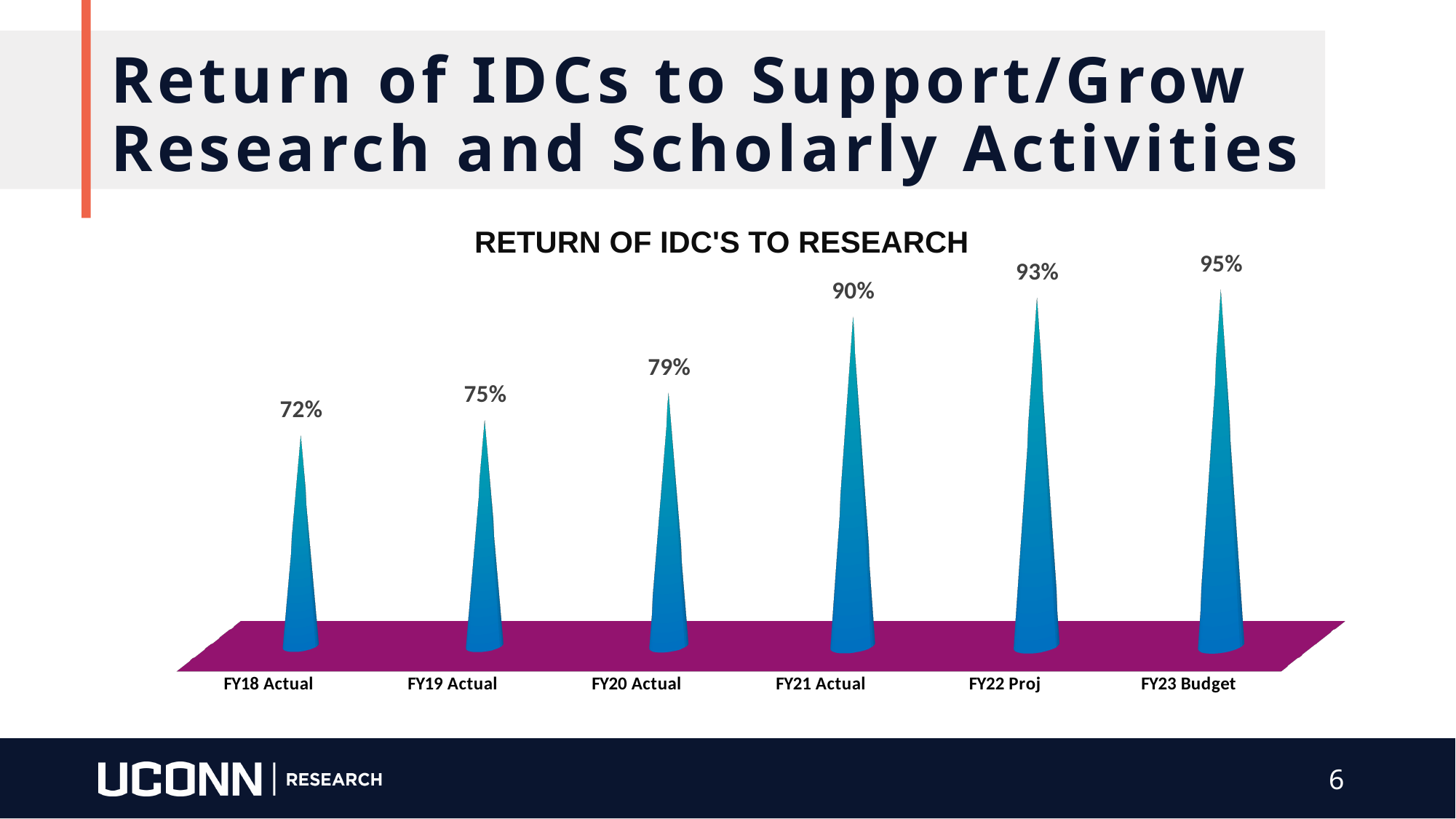
Which category has the highest value? FY23 Budget What is the value for FY18 Actual? 72% What is the title of the chart? RETURN OF IDC'S TO RESEARCH Do the values rise or fall from FY18 Actual to FY23 Budget? Rise What is the value for FY21 Actual? 90% What kind of chart is this? Bar chart What is the value for FY22 Proj? 93% Which is larger, the value for FY19 Actual or the value for FY20 Actual? FY20 Actual What is the difference between the values for FY23 Budget and FY18 Actual? 23% What is the difference between the values for FY21 Actual and FY20 Actual? 11% Which category has the lowest value? FY18 Actual How many categories are shown on the x axis? 6